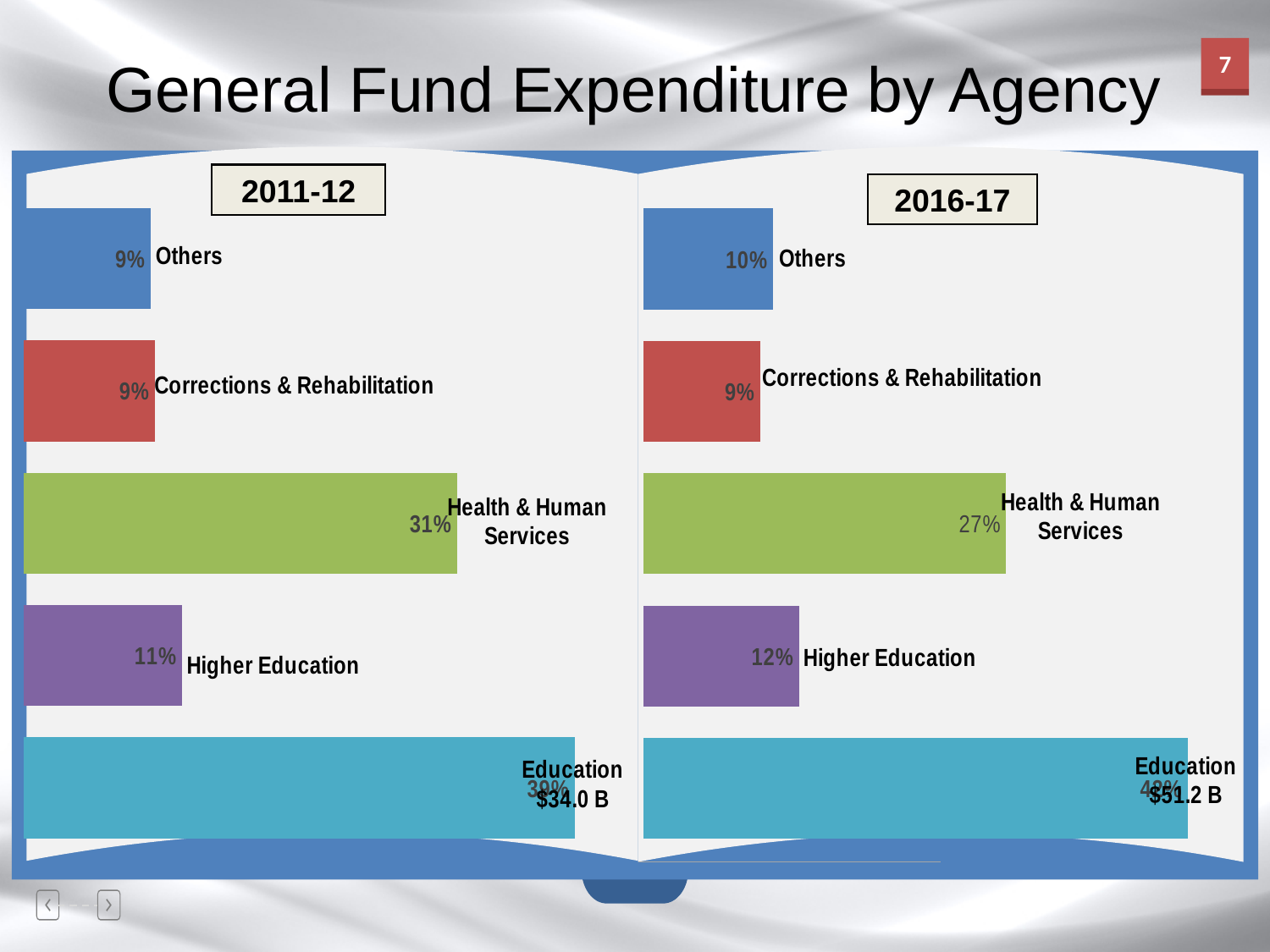
In the 2011-12 chart, what percentage is shown for Higher Education? 11% In the 2016-17 chart, what percentage is shown for Others? 10% In the 2016-17 chart, which agency has the largest share of expenditure? Education In the 2011-12 chart, what percentage is shown for Health & Human Services? 31% In the 2011-12 chart, which agency has the largest share of expenditure? Education In the 2016-17 chart, what percentage is shown for Corrections & Rehabilitation? 9% What type of chart is used for the 2011-12 data? Bar chart How many agency categories are shown in the 2016-17 chart? 5 In the 2016-17 chart, what percentage is shown for Health & Human Services? 27% In the 2016-17 chart, which is larger, the share for Higher Education or the share for Others? Higher Education What is the title of the slide containing the two charts? General Fund Expenditure by Agency In the 2011-12 chart, what is the difference in percentage points between Health & Human Services and Higher Education? 20